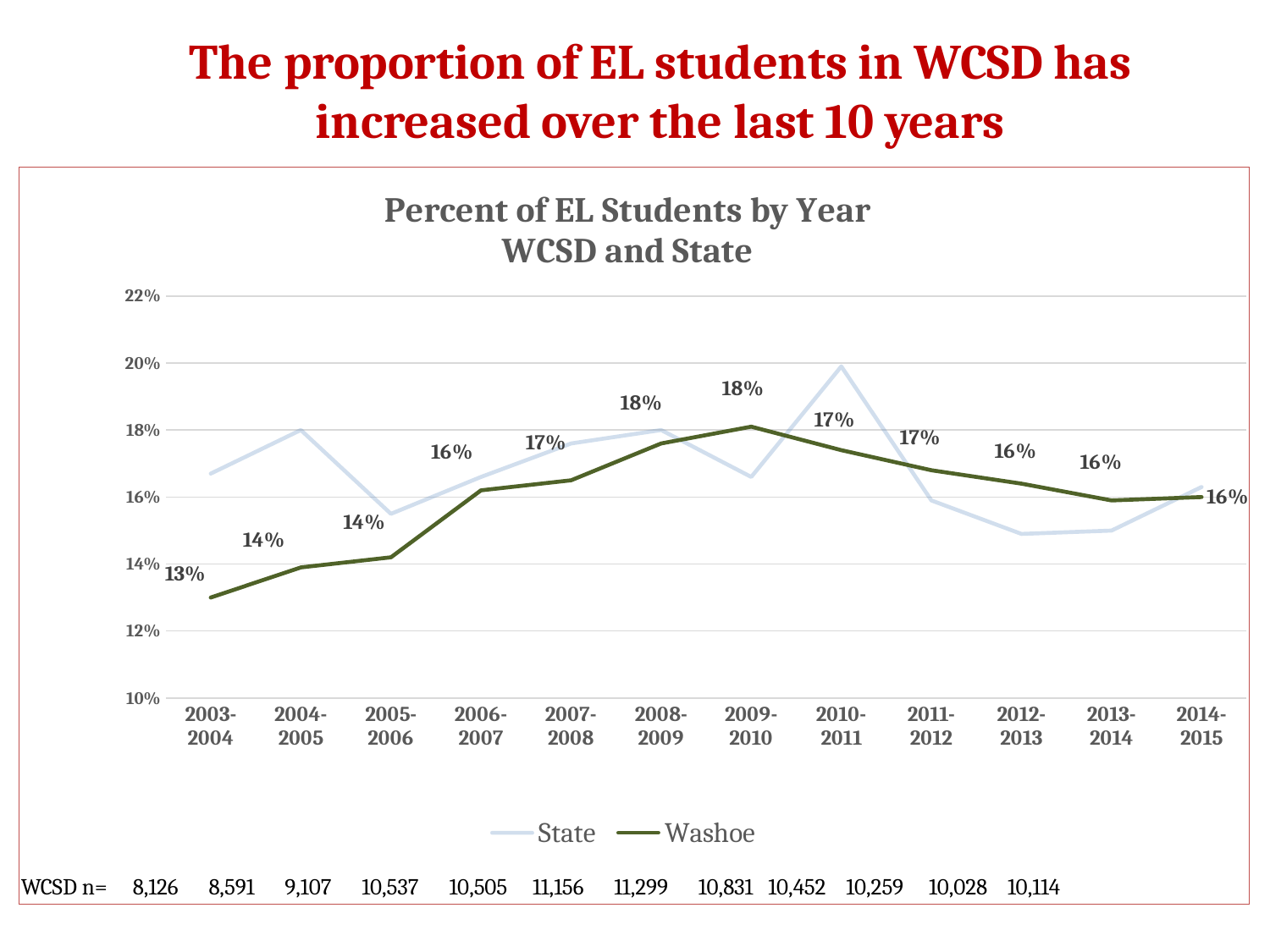
What is the Washoe value for 2014-2015? 16% How many series does the legend list? 2 What is the Washoe value for 2003-2004? 13% Is the State value for 2012-2013 greater or less than 16%? less In 2010-2011, which series has the higher value, State or Washoe? State What is the Washoe value for 2009-2010? 18% What are the two series named in the legend? State and Washoe What type of chart is shown on the slide? Line chart Does the Washoe line rise or fall from 2003-2004 to 2009-2010? Rise How many school years are shown on the x axis? 12 In which school year is the Washoe value lowest? 2003-2004 What is the difference between the Washoe value in 2009-2010 and in 2003-2004? 5 percentage points